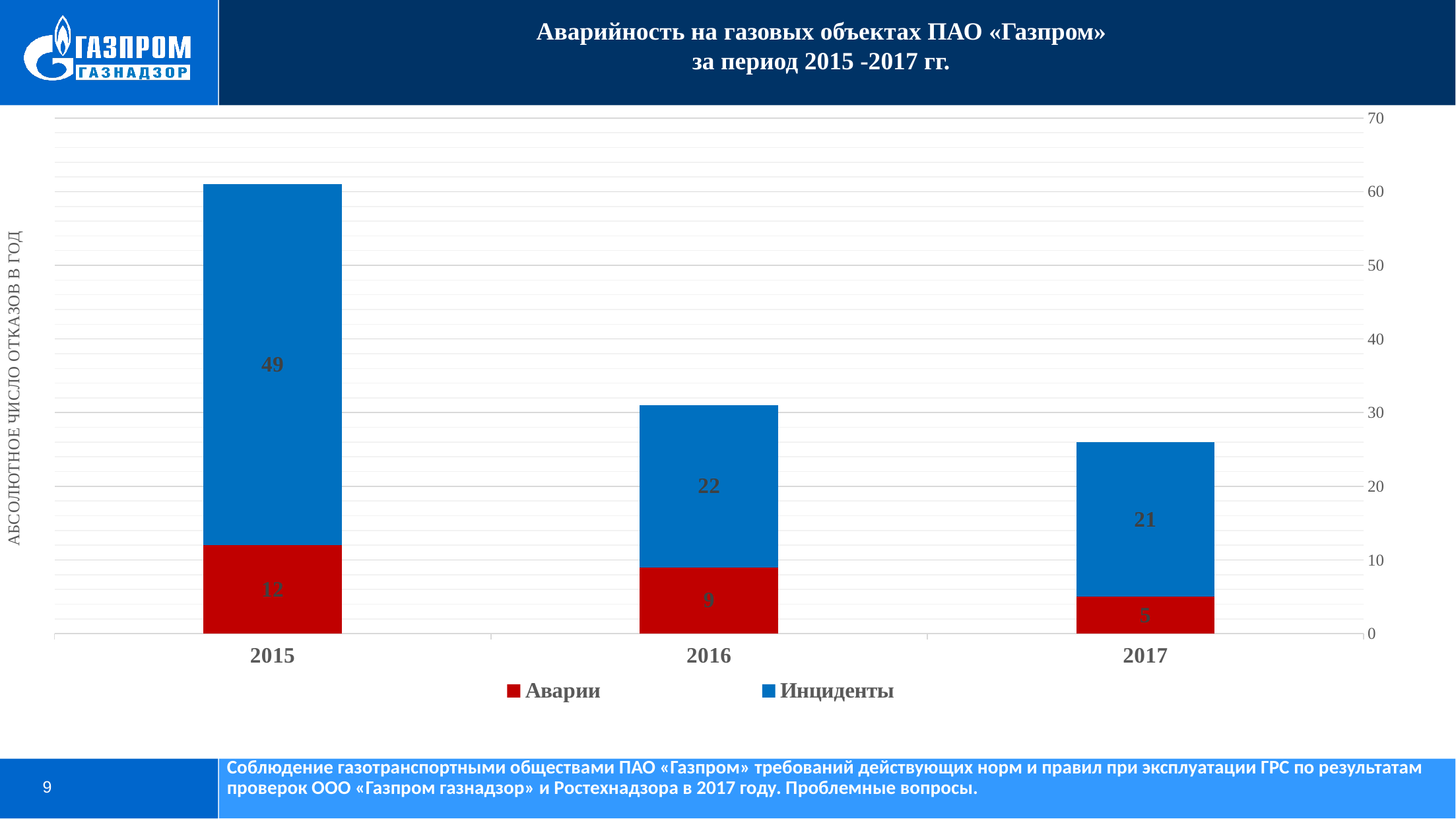
Which is larger: Аварии in 2016 or Аварии in 2017? Аварии in 2016 What is the total of the stacked bar for 2015? 61 How many years are shown on the x axis? 3 Which year has the highest value for Инциденты? 2015 What is the value of Аварии for 2017? 5 What is the value of Инциденты for 2016? 22 What is the value of Аварии for 2015? 12 How many series does the legend list? 2 Which year has the lowest value for Аварии? 2017 What kind of chart is shown on the slide? Stacked bar chart What is the total of the stacked bar for 2016? 31 What is the difference between Инциденты in 2015 and Инциденты in 2017? 28